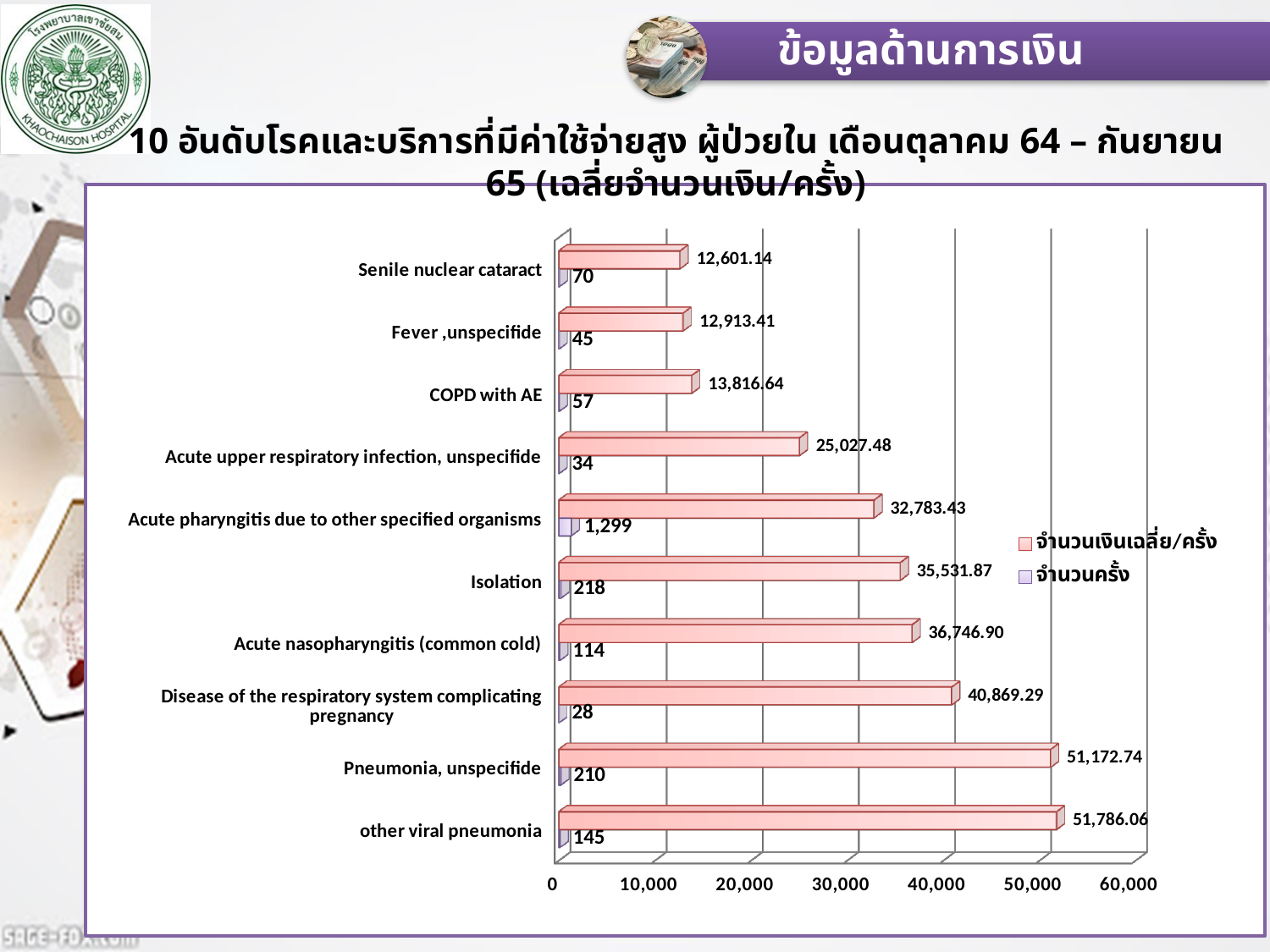
Which category has the highest average amount per visit? other viral pneumonia Which category has the lowest average amount per visit? Senile nuclear cataract What is the number of visits for Disease of the respiratory system complicating pregnancy? 28 What is the average amount per visit for Isolation? 35,531.87 What is the number of visits (จำนวนครั้ง) for Acute pharyngitis due to other specified organisms? 1,299 What is the average amount per visit (จำนวนเงินเฉลี่ย/ครั้ง) for Pneumonia, unspecifide? 51,172.74 What type of chart is shown on the slide? Bar chart How many series does the legend list? 2 Which category has the highest number of visits (จำนวนครั้ง)? Acute pharyngitis due to other specified organisms How many disease categories are shown on the chart? 10 What is the difference in average amount per visit between other viral pneumonia and Pneumonia, unspecifide? 613.32 Which has a larger average amount per visit: COPD with AE or Acute upper respiratory infection, unspecifide? Acute upper respiratory infection, unspecifide